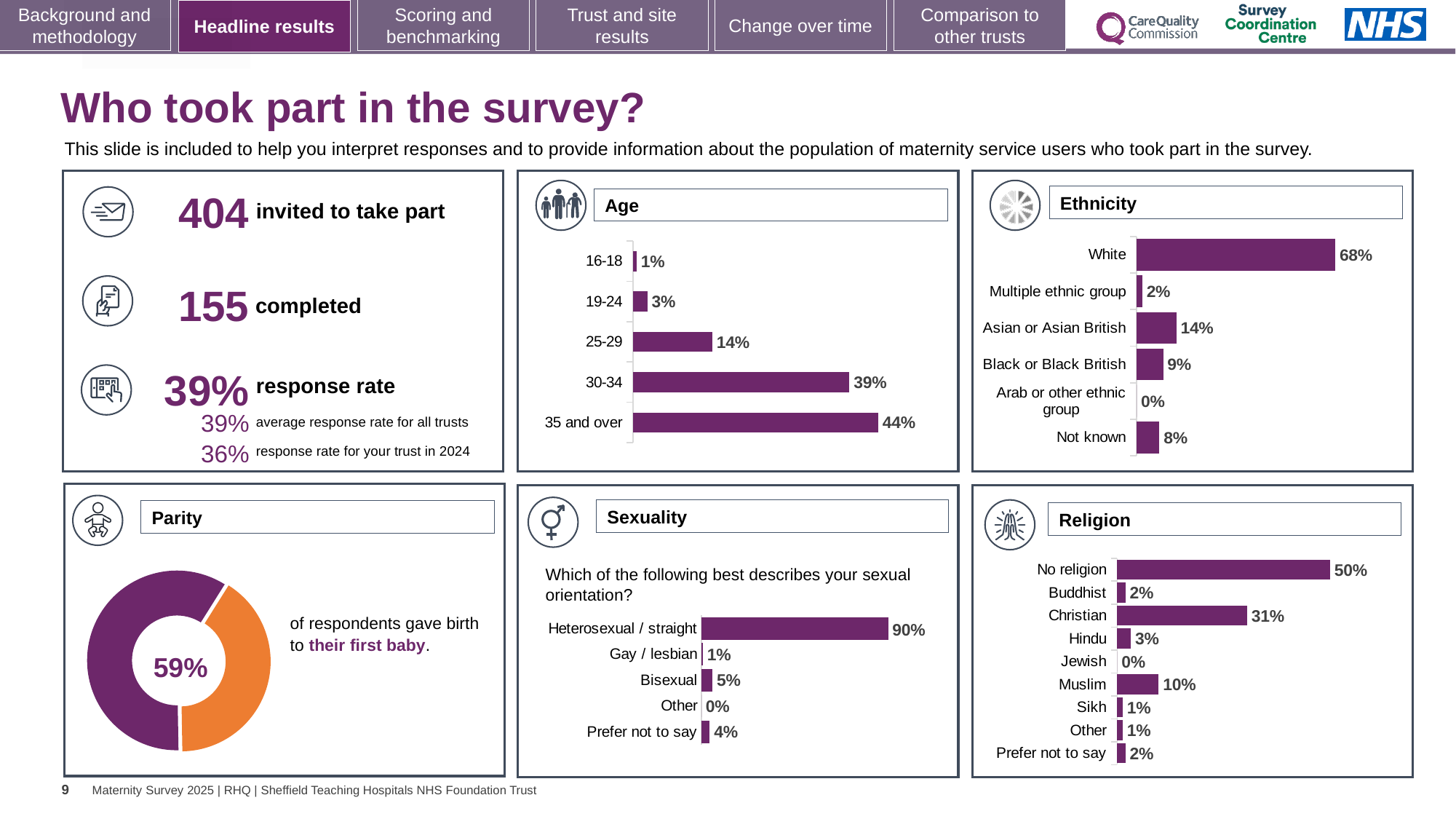
In the Ethnicity chart, what is the difference between White and Black or Black British? 59% In the Sexuality chart, how many response categories are shown? 5 In the Religion chart, what is the value for Muslim? 10% In the Religion chart, which religion category has the highest percentage? No religion In the Ethnicity chart, how many ethnicity categories are shown? 6 In the Ethnicity chart, what is the value for Asian or Asian British? 14% In the Age chart, which age group has the highest percentage? 35 and over In the Religion chart, which is larger, Christian or Hindu? Christian What kind of chart is the Parity chart? Doughnut chart In the Sexuality chart, what percentage of respondents answered Heterosexual / straight? 90% In the Age chart, what percentage of respondents were aged 30-34? 39% In the Parity chart, what share of respondents gave birth to their first baby? 59%